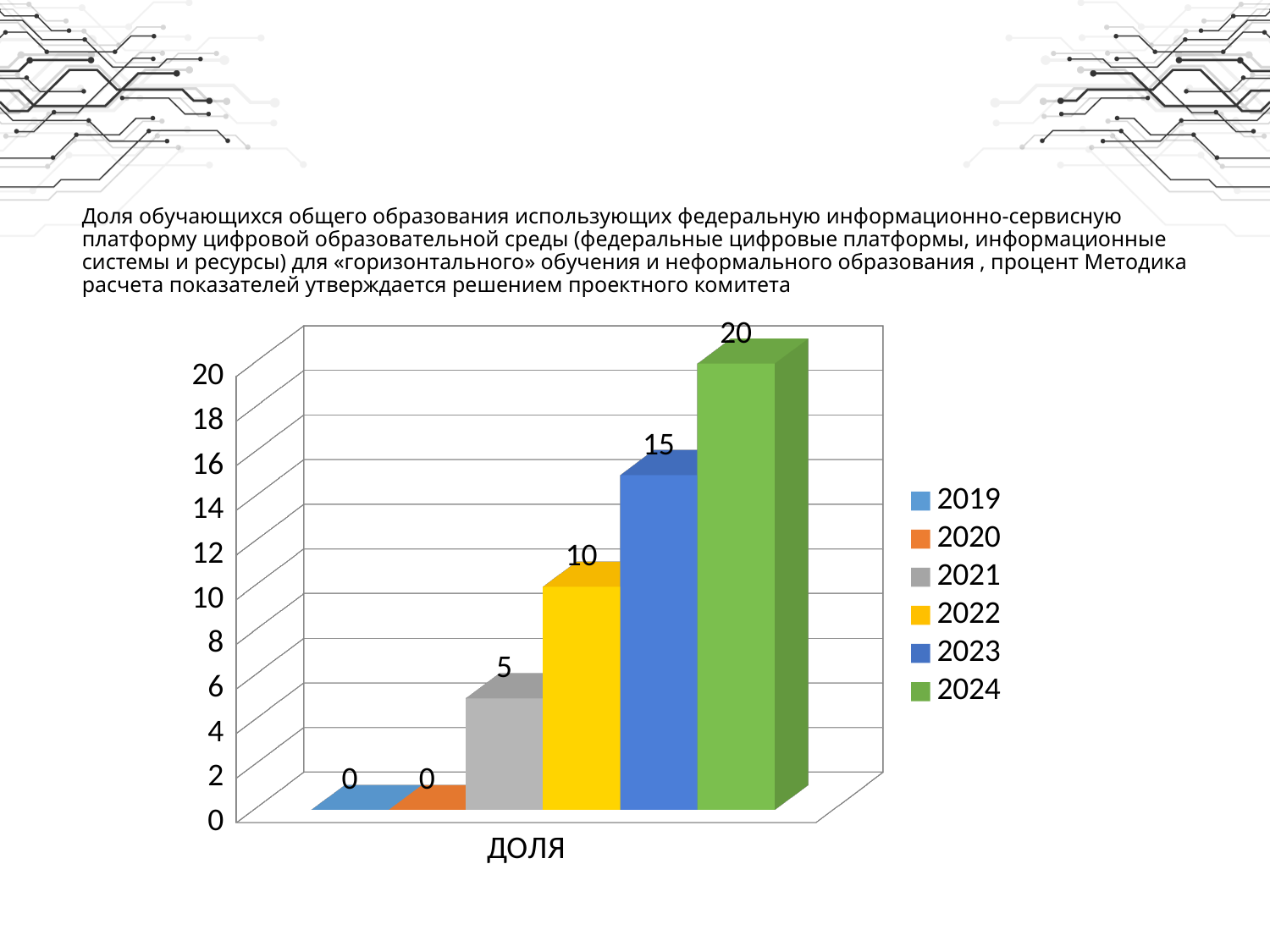
Which is larger, the value for 2023 or the value for 2022? 2023 How many series does the legend list? 6 What is the difference between the values for 2024 and 2023? 5 What is the value for 2021 in the chart? 5 What is the value for 2019 in the chart? 0 What kind of chart is shown on the slide? bar chart Which year has the highest value in the chart? 2024 What is the category label shown on the x axis of the chart? ДОЛЯ What is the difference between the values for 2022 and 2021? 5 What is the value for 2024 in the chart? 20 Do the values rise or fall from 2019 to 2024? rise What is the value for 2022 in the chart? 10